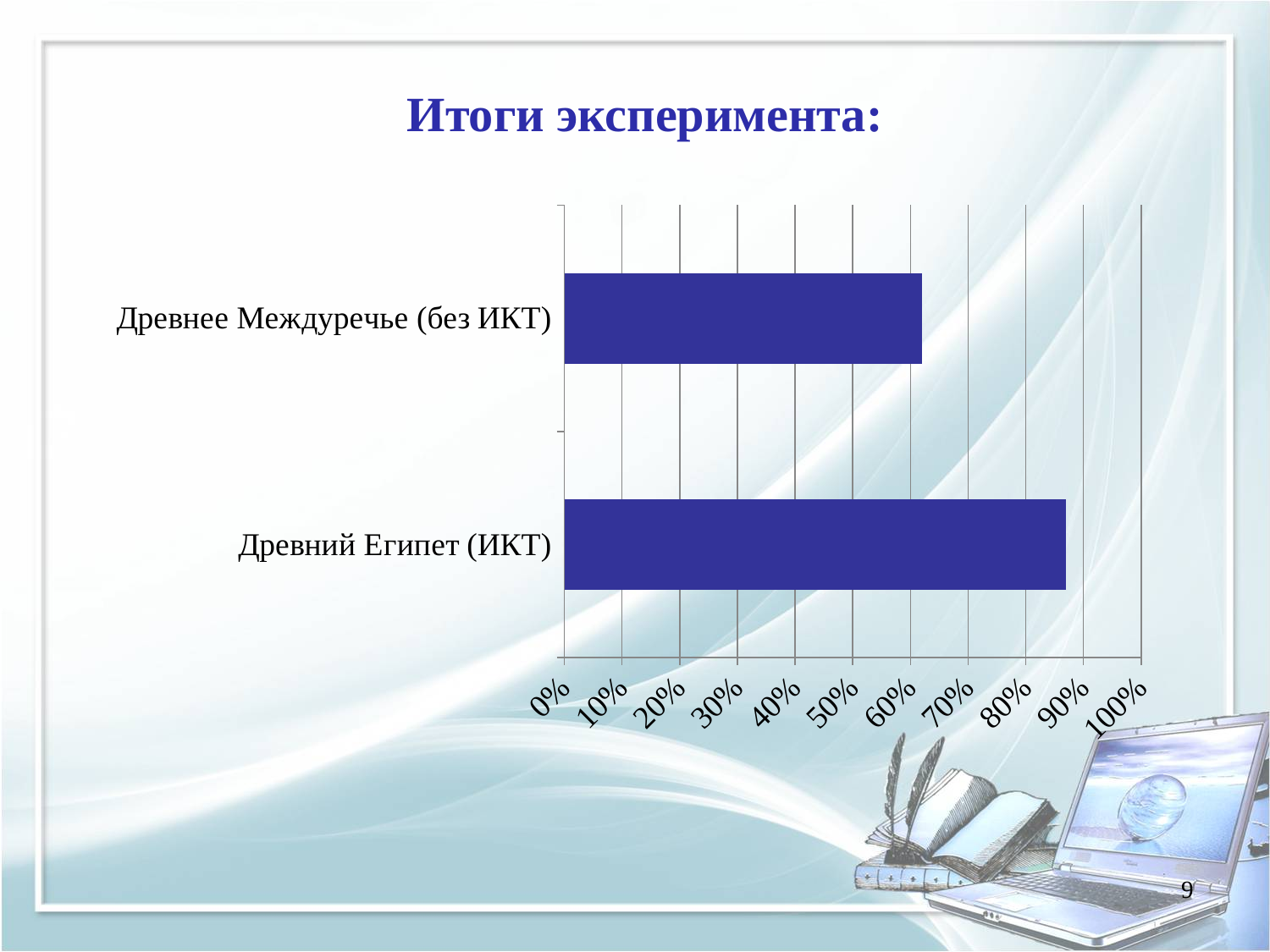
Which category has the highest value? Древний Египет (ИКТ) How many categories are plotted in the chart? 2 Is the value for Древний Египет (ИКТ) greater or less than 90%? less Is the value for Древнее Междуречье (без ИКТ) greater or less than 50%? greater What is the title of the slide containing the chart? Итоги эксперимента: Which category has the lowest value? Древнее Междуречье (без ИКТ) Which is larger: the value for Древний Египет (ИКТ) or the value for Древнее Междуречье (без ИКТ)? Древний Египет (ИКТ) Is the value for Древний Египет (ИКТ) greater or less than 80%? greater What kind of chart is shown on the slide? bar chart What is the maximum value shown on the horizontal axis? 100%